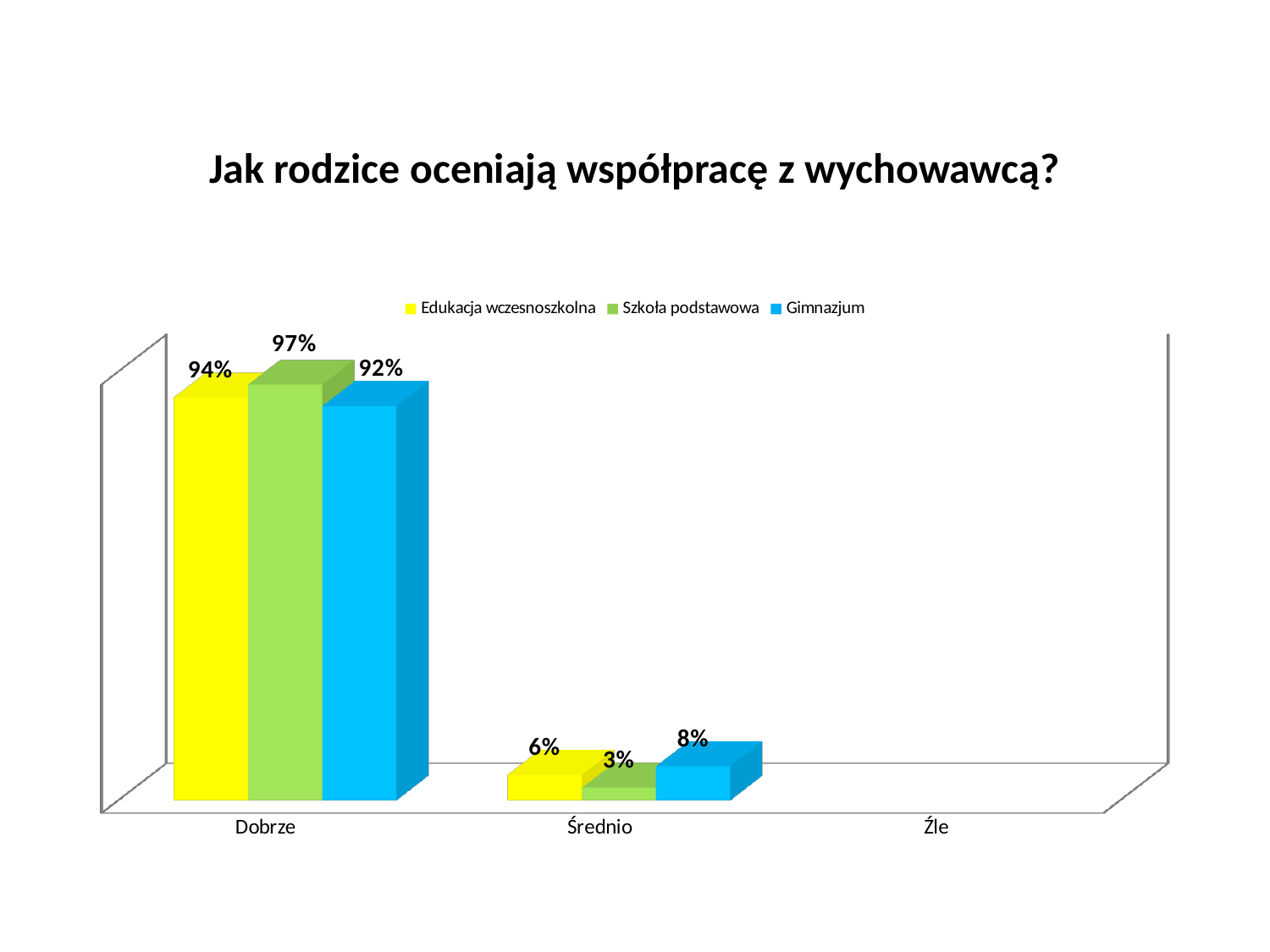
What kind of chart is shown on the slide? Bar chart How many categories are shown on the x axis? 3 Which is larger: the Edukacja wczesnoszkolna value for Dobrze or the Gimnazjum value for Dobrze? Edukacja wczesnoszkolna Which series has the lowest value in the Średnio category? Szkoła podstawowa What is the value for Szkoła podstawowa in the Średnio category? 3% What is the difference between the Gimnazjum and Edukacja wczesnoszkolna values in the Średnio category? 2% What is the difference between the Szkoła podstawowa and Gimnazjum values in the Dobrze category? 5% What is the value for Szkoła podstawowa in the Dobrze category? 97% What is the value for Edukacja wczesnoszkolna in the Dobrze category? 94% What is the value for Gimnazjum in the Średnio category? 8% Which series has the highest value in the Dobrze category? Szkoła podstawowa How many series does the legend list? 3